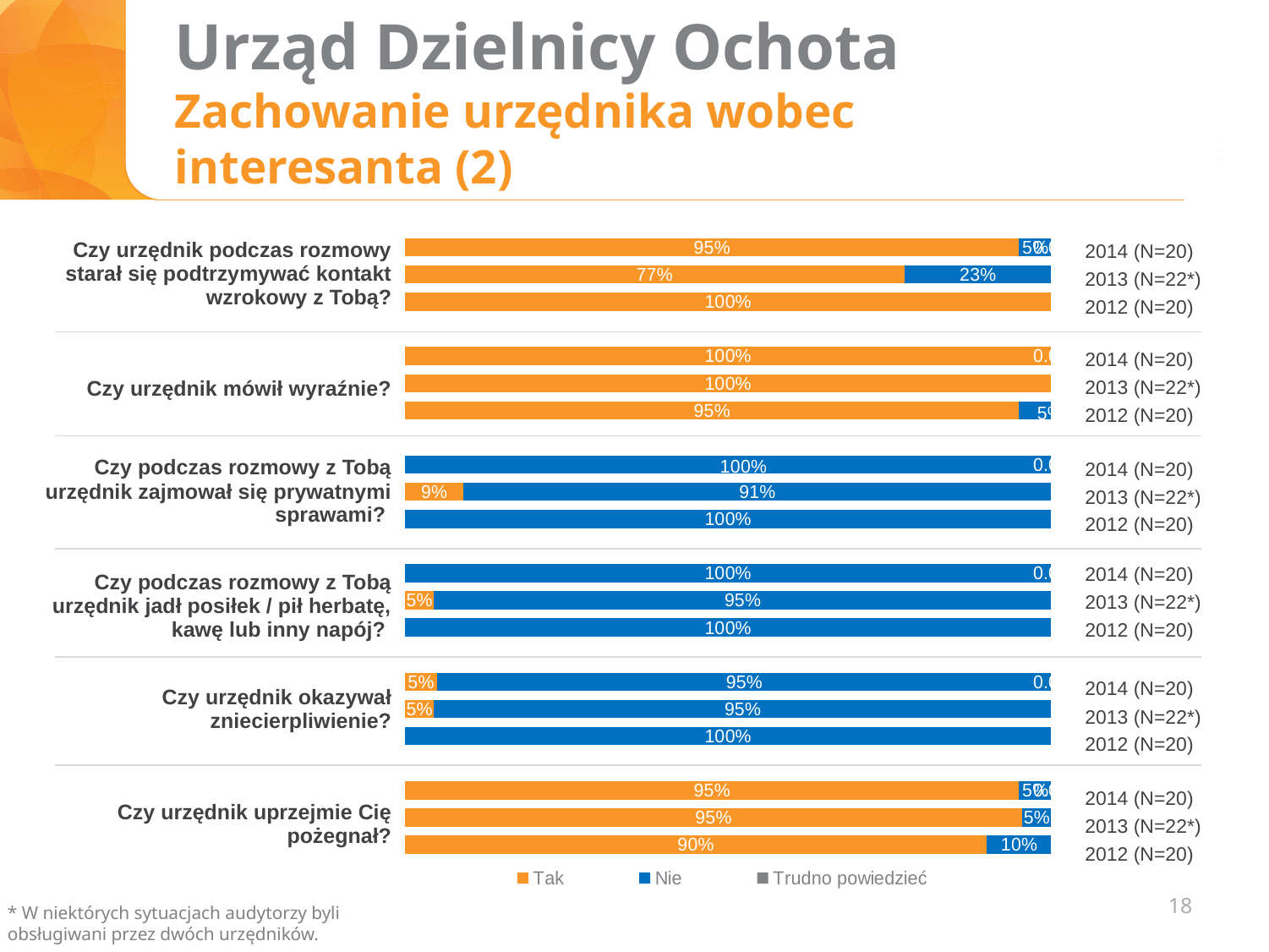
For the question "Czy urzędnik podczas rozmowy starał się podtrzymywać kontakt wzrokowy z Tobą?" in 2013, what is the difference between the "Tak" and "Nie" values? 54 percentage points For the question "Czy urzędnik podczas rozmowy starał się podtrzymywać kontakt wzrokowy z Tobą?", what is the "Nie" value for 2013 (N=22*)? 23% How many series does the chart legend list? 3 For the question "Czy urzędnik okazywał zniecierpliwienie?" in 2013 (N=22*), which is larger, the "Tak" value or the "Nie" value? Nie For the question "Czy podczas rozmowy z Tobą urzędnik jadł posiłek / pił herbatę, kawę lub inny napój?", what is the "Tak" value for 2013 (N=22*)? 5% For the question "Czy urzędnik uprzejmie Cię pożegnał?", what is the "Tak" value for 2012 (N=20)? 90% What are the three entries in the chart legend? Tak, Nie, Trudno powiedzieć For the question "Czy urzędnik uprzejmie Cię pożegnał?", what is the "Nie" value for 2012 (N=20)? 10% What kind of chart is shown on the slide? Stacked bar chart For the question "Czy podczas rozmowy z Tobą urzędnik zajmował się prywatnymi sprawami?", what is the "Nie" value for 2013 (N=22*)? 91% For the question "Czy urzędnik podczas rozmowy starał się podtrzymywać kontakt wzrokowy z Tobą?", what is the "Tak" value for 2013 (N=22*)? 77% For the question "Czy urzędnik mówił wyraźnie?", what is the "Tak" value for 2012 (N=20)? 95%